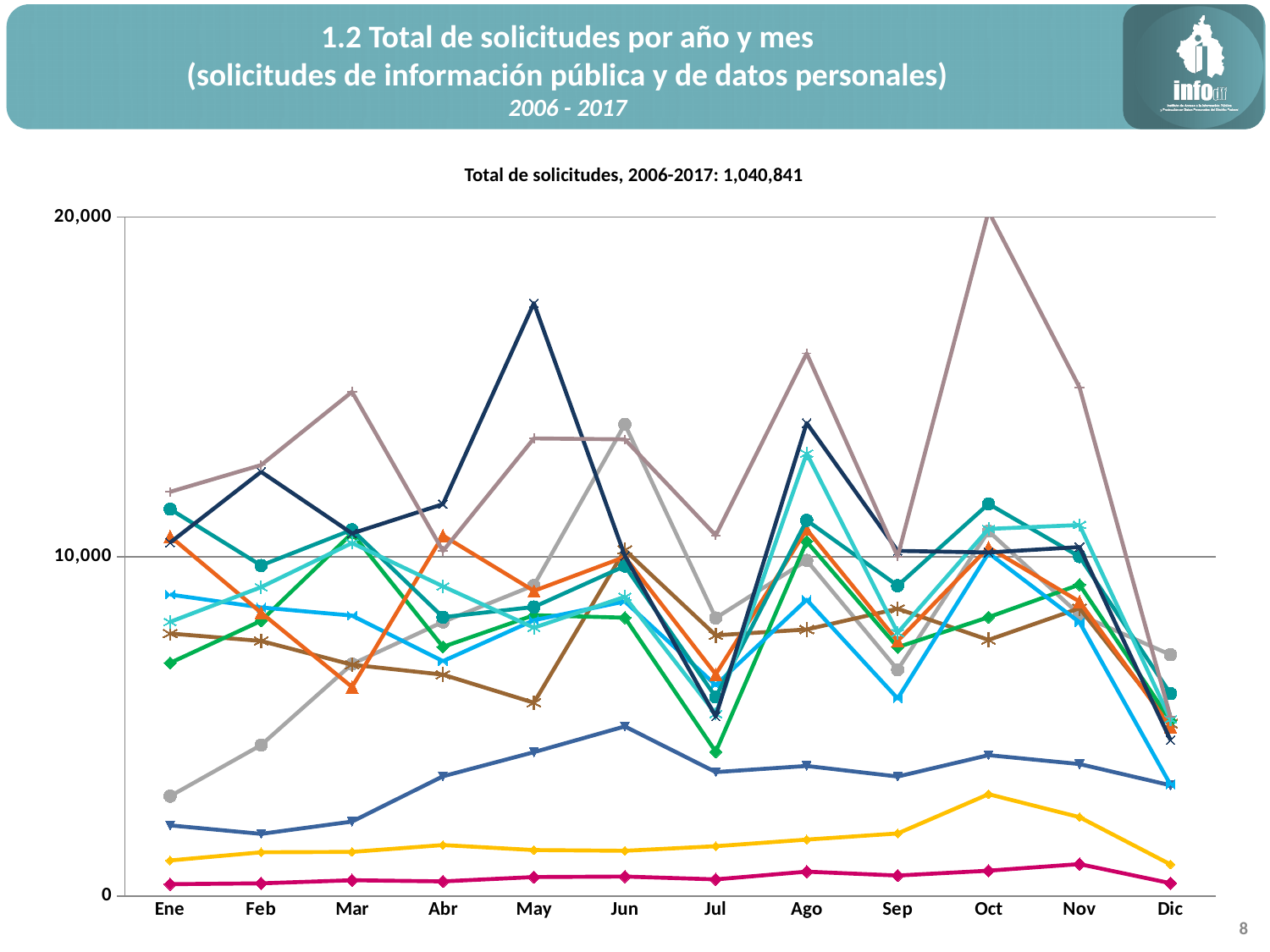
What is the first month shown on the x axis of the chart? Ene What is the title of the chart? Total de solicitudes, 2006-2017: 1,040,841 In which month does the highest plotted point on the chart occur? Oct What is the total number of solicitudes for 2006-2017 stated in the chart title? 1,040,841 What is the last month shown on the x axis of the chart? Dic What kind of chart is shown on the slide? line chart Which range of years does the chart cover according to its title? 2006-2017 What is the highest value labelled on the y axis of the chart? 20,000 How many months are shown along the x axis of the chart? 12